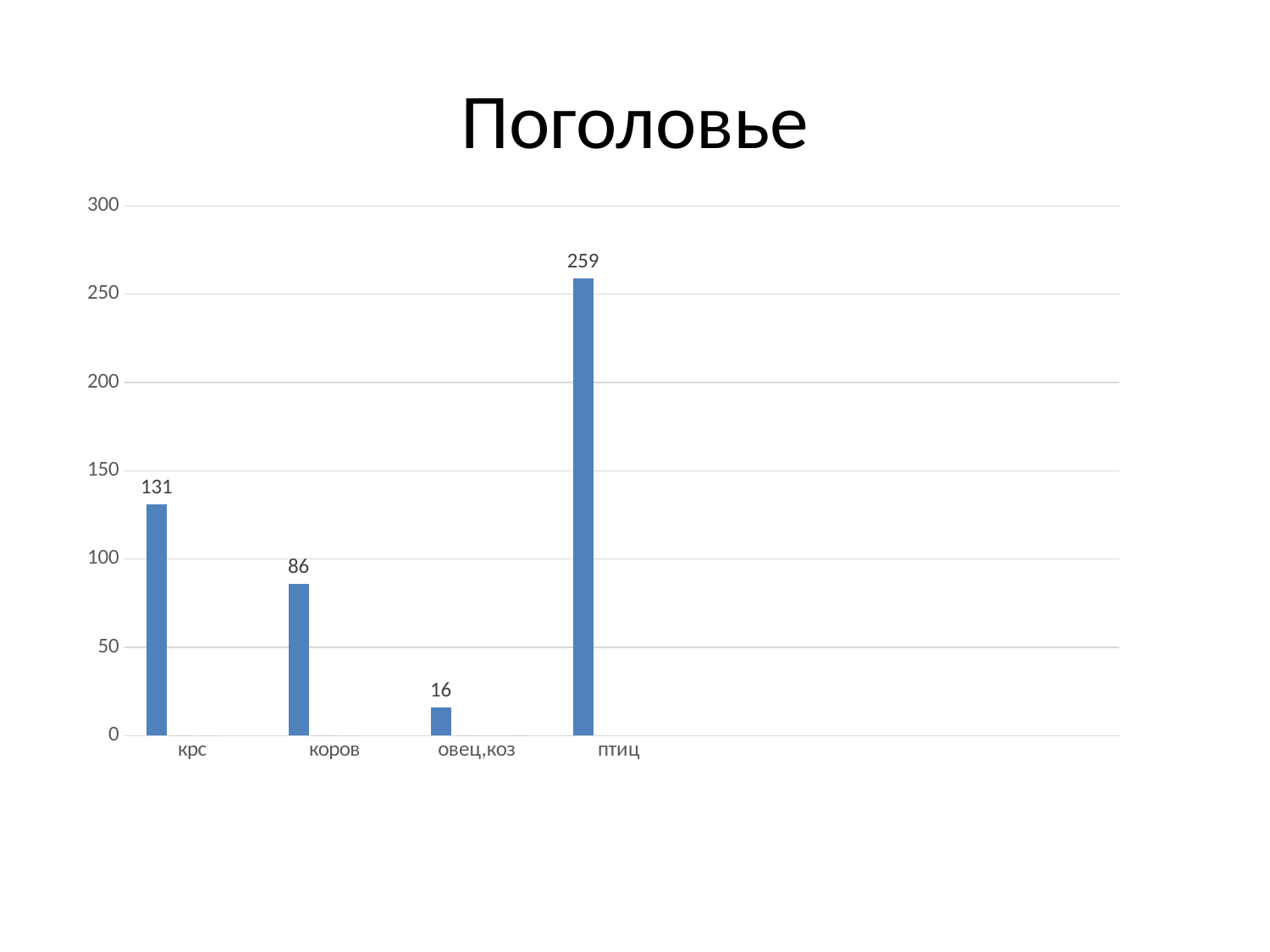
What is the value for коров? 86 Which category has the lowest value? овец,коз What is the value for овец,коз? 16 What is the value for птиц? 259 What is the difference between the values for крс and коров? 45 What is the value for крс? 131 How many categories are shown on the chart? 4 What is the difference between the values for птиц and крс? 128 Which is larger, the value for коров or the value for овец,коз? коров What is the title of the chart? Поголовье Is the value for птиц greater or less than 250? greater Which category has the highest value? птиц